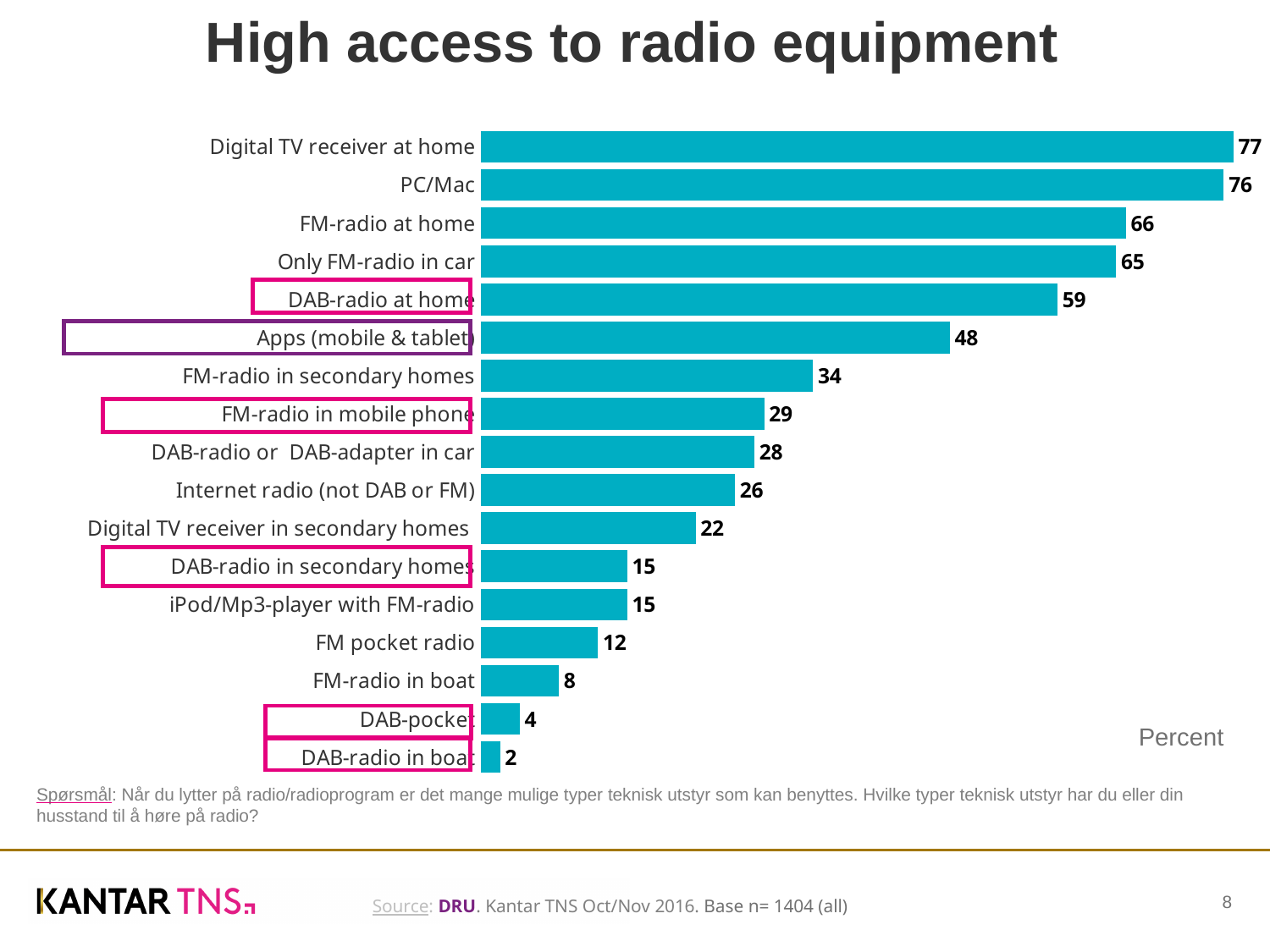
What is the title of the slide? High access to radio equipment What is the value for Apps (mobile & tablet)? 48 What kind of chart is shown on the slide? Bar chart What is the value for PC/Mac? 76 What is the difference between Digital TV receiver at home and Digital TV receiver in secondary homes? 55 Which is larger, FM-radio in mobile phone or Internet radio (not DAB or FM)? FM-radio in mobile phone What is the difference between FM-radio at home and DAB-radio at home? 7 What is the value for DAB-radio or DAB-adapter in car? 28 Which category has the highest value? Digital TV receiver at home Which category has the lowest value? DAB-radio in boat How many categories are shown in the chart? 17 What is the value for DAB-radio at home? 59